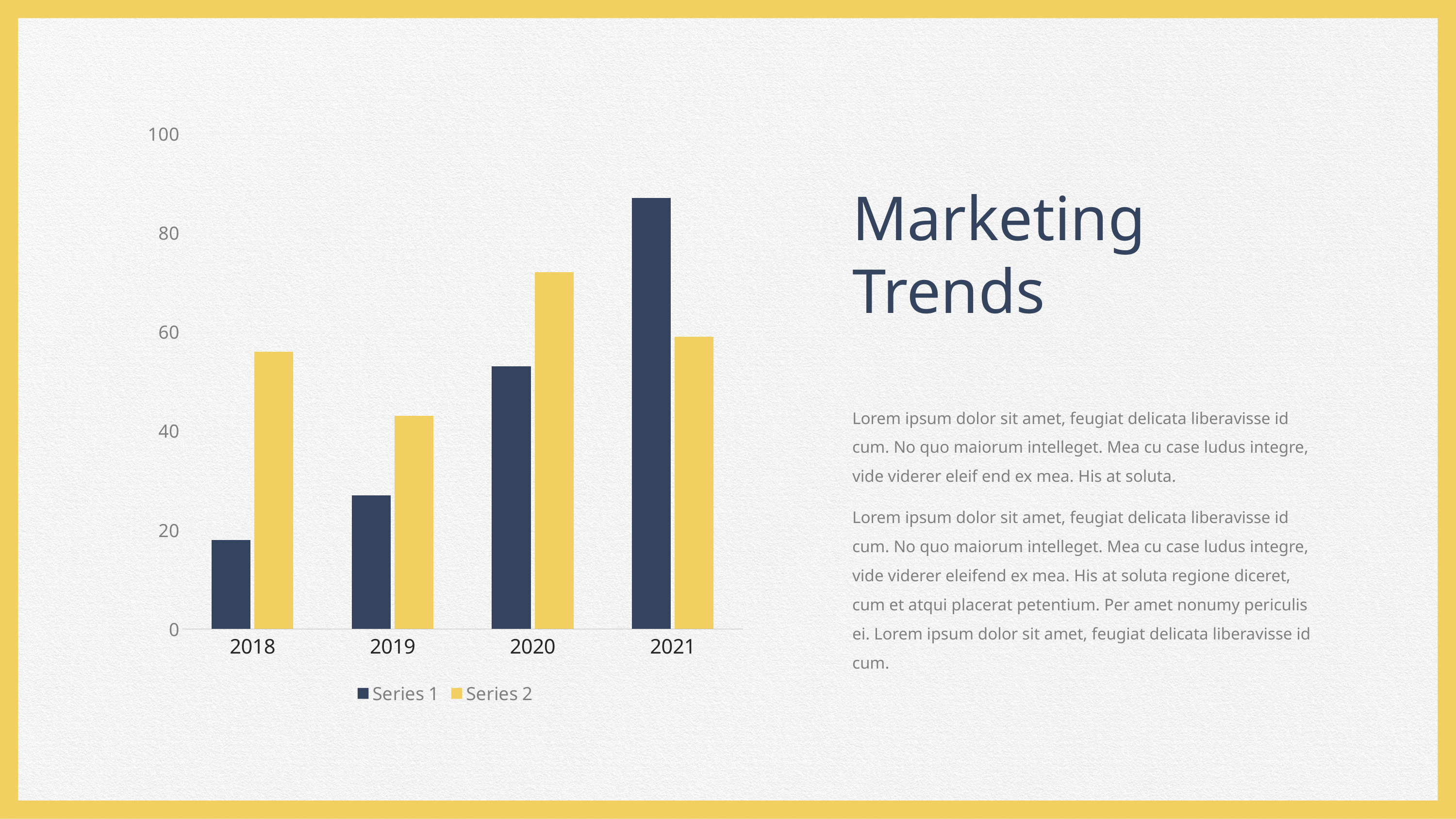
How many series does the chart's legend list? 2 Do the Series 1 values rise or fall from 2018 to 2021? rise Which year has the highest value for Series 1? 2021 Is the value for Series 1 in 2018 greater or less than 20? less Is the value for Series 1 in 2021 greater or less than 80? greater Which year has the highest value for Series 2? 2020 In 2021, which series has the larger value, Series 1 or Series 2? Series 1 Which year has the lowest value for Series 2? 2019 Which year has the lowest value for Series 1? 2018 In 2018, which series has the larger value, Series 1 or Series 2? Series 2 What kind of chart is shown on the slide? bar chart How many years are shown on the x axis of the chart? 4